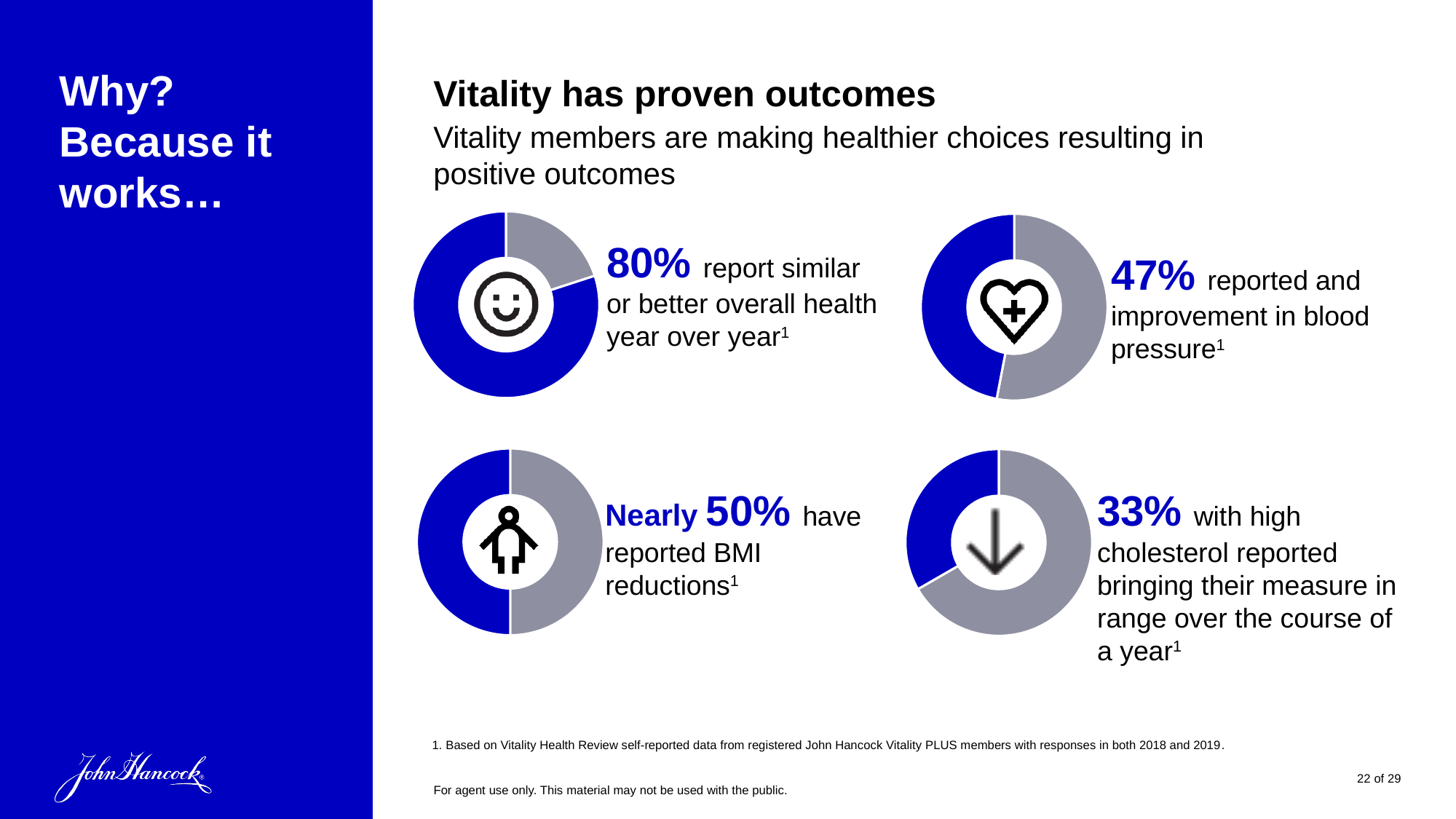
How many donut charts are shown on the slide? 4 What colour is used for the highlighted (reported) portion of each donut chart? Blue What is the difference in percentage points between the blood pressure figure (47%) and the cholesterol figure (33%)? 14 percentage points What is the difference in percentage points between the overall health figure (80%) and the blood pressure figure (47%)? 33 percentage points In the bottom-left donut chart (person icon), what share of members have reported BMI reductions? Nearly 50% Which is larger: the percentage reporting an improvement in blood pressure or the percentage with high cholesterol bringing their measure in range? Improvement in blood pressure (47%) Which of the four outcomes shown has the lowest percentage? High cholesterol brought in range (33%) In the top-left donut chart (smiley face icon), what percentage of members report similar or better overall health year over year? 80% Which of the four outcomes shown has the highest percentage? Similar or better overall health year over year (80%) In the bottom-right donut chart (down arrow icon), what percentage of members with high cholesterol reported bringing their measure in range over the course of a year? 33% In the top-right donut chart (heart icon), what percentage reported an improvement in blood pressure? 47% What kind of chart is used to show each of the four outcome statistics on the slide? donut chart